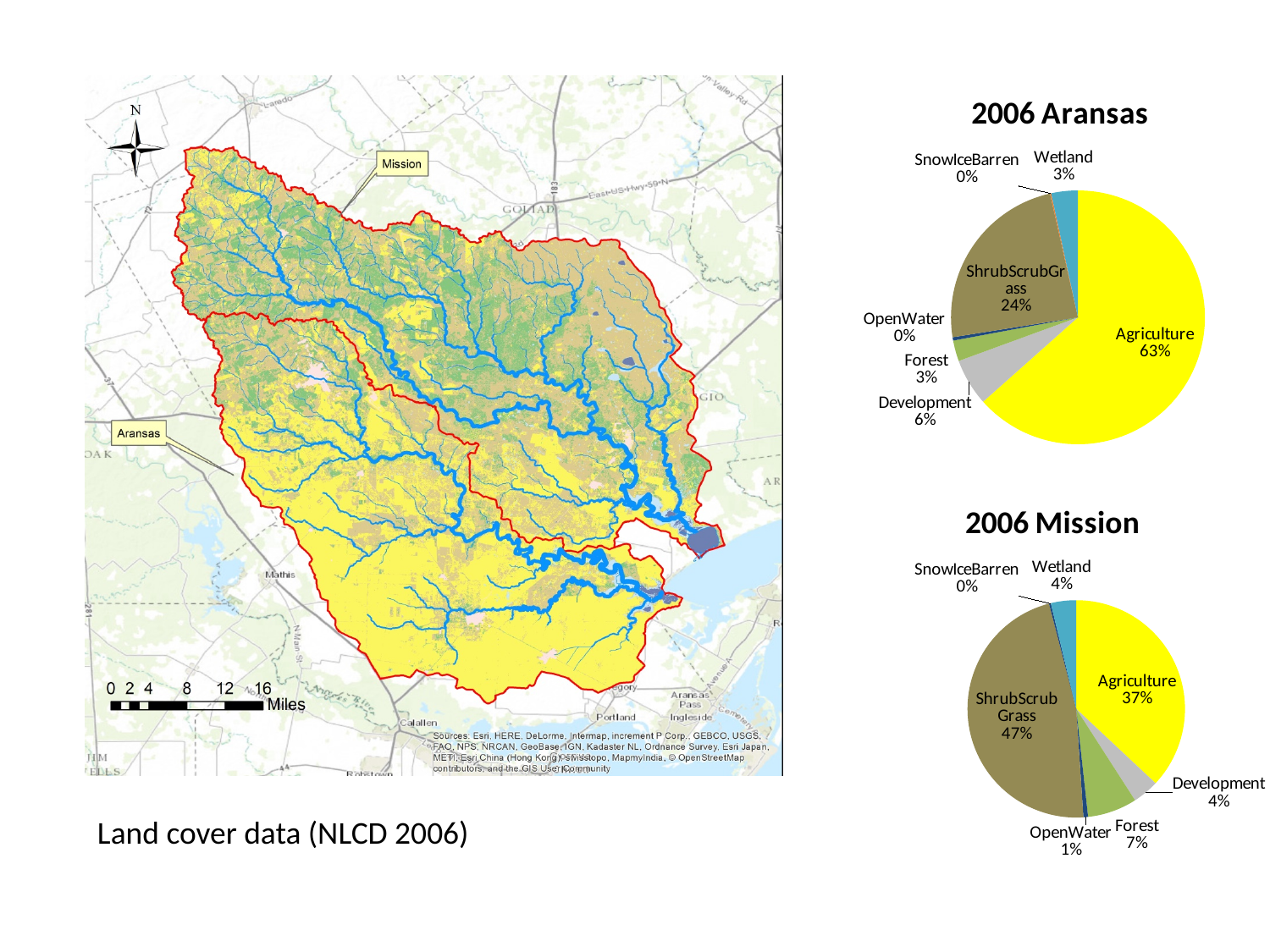
In the 2006 Mission chart, what share does ShrubScrubGrass have? 47% In the 2006 Mission chart, which is larger, Forest or Development? Forest In the 2006 Mission chart, what is the difference between the ShrubScrubGrass share and the Agriculture share? 10% In the 2006 Aransas chart, which category has the largest share? Agriculture In the 2006 Mission chart, what is the share for Forest? 7% In the 2006 Mission chart, which category has the largest share? ShrubScrubGrass In the 2006 Aransas chart, what is the difference between the Agriculture share and the ShrubScrubGrass share? 39% How many categories are labelled in the 2006 Aransas chart? 7 In the 2006 Aransas chart, what share does Agriculture have? 63% What type of chart is the 2006 Mission chart? Pie chart In the 2006 Mission chart, what is the share for OpenWater? 1% In the 2006 Aransas chart, which is larger, Development or Forest? Development